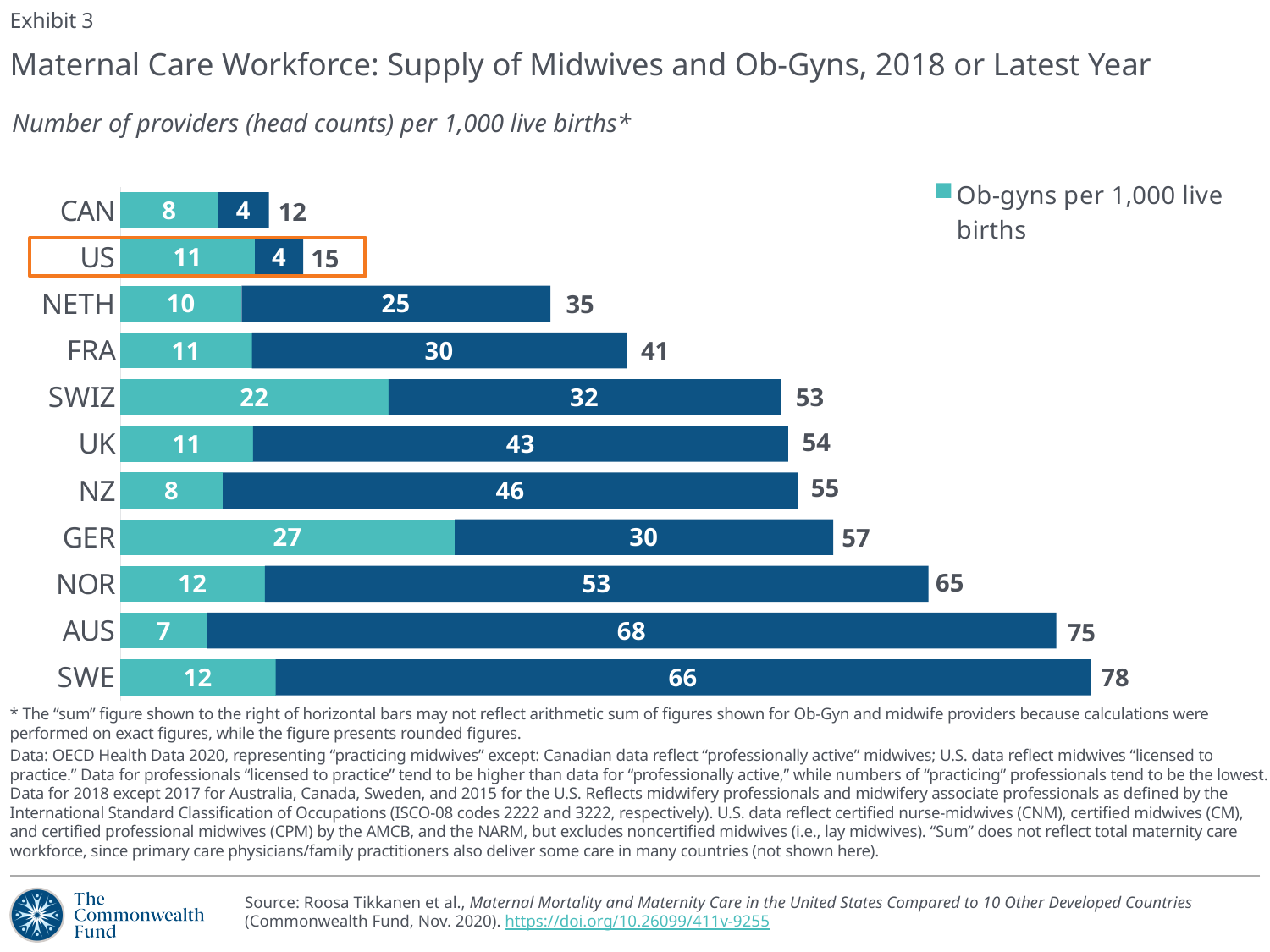
What is the sum figure shown to the right of the bar for the US? 15 What is the difference between the dark blue segment values for UK and NZ? 3 What is the value of the dark blue segment for AUS? 68 What is the value of Ob-gyns per 1,000 live births for SWIZ? 22 Which country has the lowest sum figure? CAN What is the sum figure shown to the right of the bar for SWE? 78 What is the value of Ob-gyns per 1,000 live births for GER? 27 Which country's bar is highlighted with an orange outline? US What type of chart is shown on the slide? stacked bar chart How many countries are shown in the chart? 11 Which country has the highest value of Ob-gyns per 1,000 live births? GER Which country has the highest sum figure? SWE